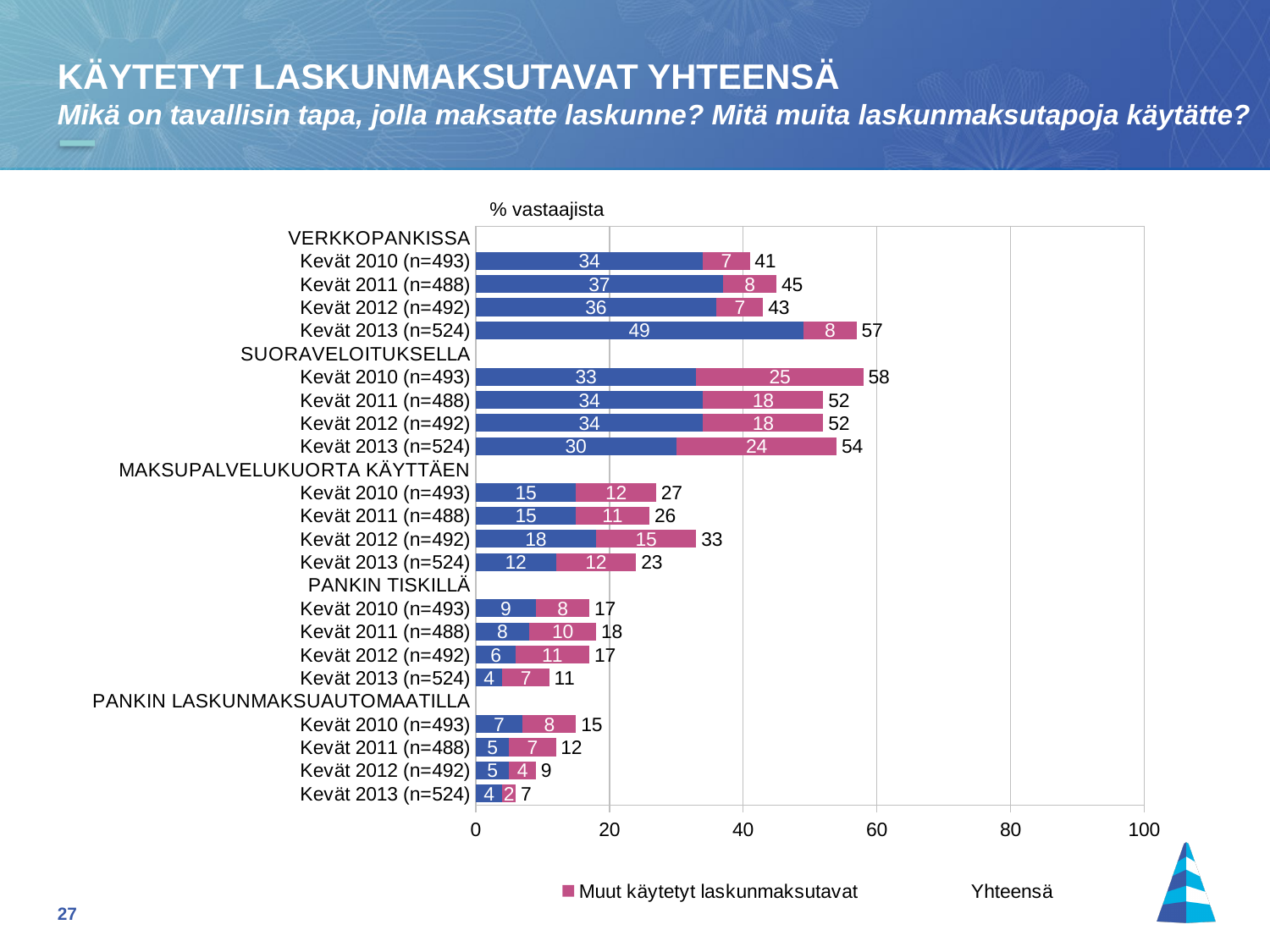
What type of chart is shown on the slide? stacked bar chart What is the value of the pink 'Muut käytetyt laskunmaksutavat' segment for SUORAVELOITUKSELLA in Kevät 2010 (n=493)? 25 What is the value of the blue segment for MAKSUPALVELUKUORTA KÄYTTÄEN in Kevät 2012 (n=492)? 18 What is the difference between the total for VERKKOPANKISSA in Kevät 2013 (n=524) and in Kevät 2012 (n=492)? 14 Which bar has the lowest total (Yhteensä) value on the chart? PANKIN LASKUNMAKSUAUTOMAATILLA Kevät 2013 (n=524) How many payment-method groups (category headings) are shown on the chart? 5 What is the axis label shown above the chart? % vastaajista Is the total for SUORAVELOITUKSELLA in Kevät 2013 (n=524) greater or less than 40? greater What is the total (Yhteensä) value for VERKKOPANKISSA in Kevät 2013 (n=524)? 57 Which bar has the highest total (Yhteensä) value on the chart? SUORAVELOITUKSELLA Kevät 2010 (n=493) What is the total (Yhteensä) value for PANKIN LASKUNMAKSUAUTOMAATILLA in Kevät 2013 (n=524)? 7 Which is larger: the total for PANKIN TISKILLÄ in Kevät 2011 (n=488) or the total for PANKIN LASKUNMAKSUAUTOMAATILLA in Kevät 2010 (n=493)? PANKIN TISKILLÄ Kevät 2011 (n=488)